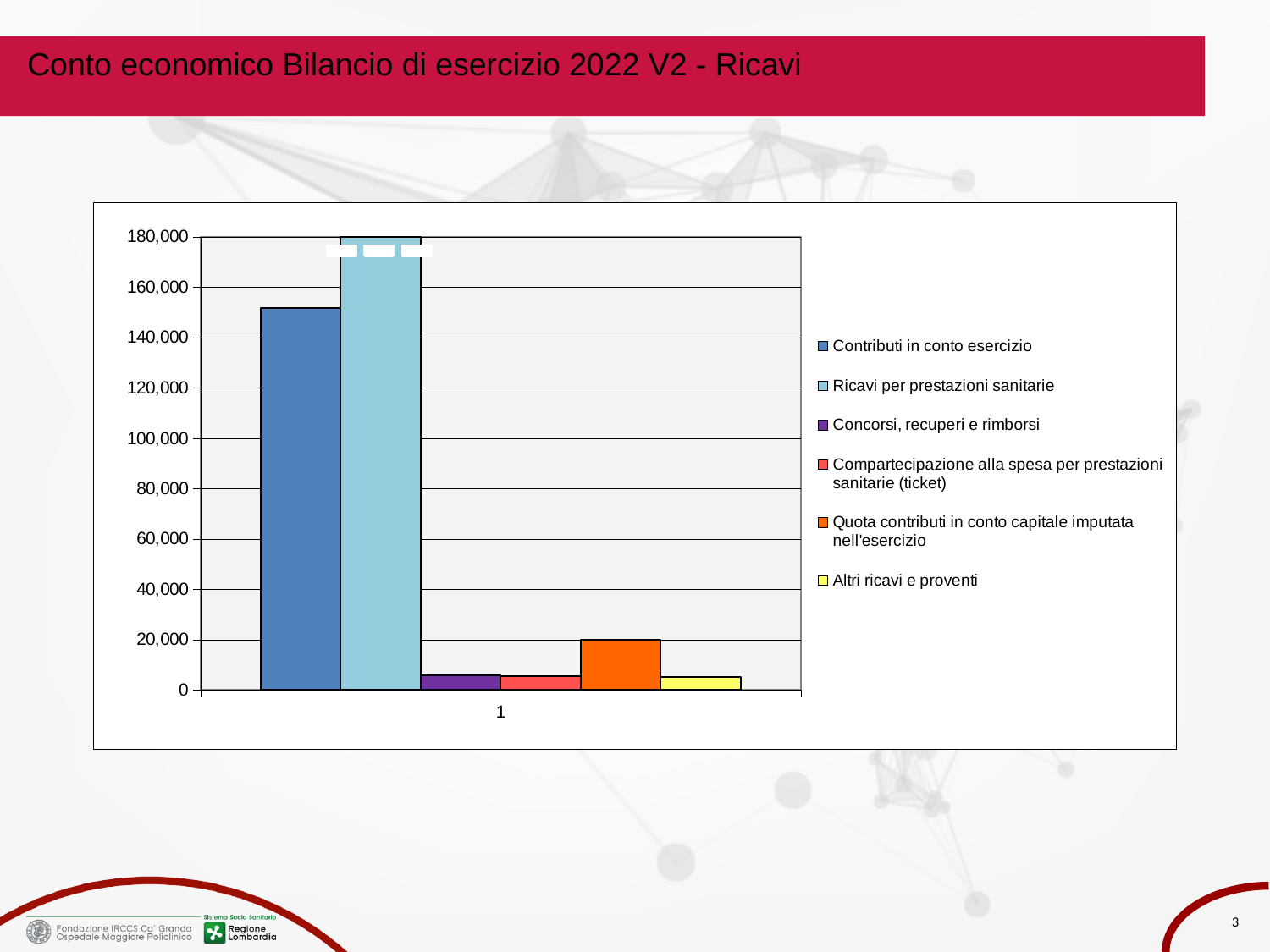
Which is larger, Quota contributi in conto capitale imputata nell'esercizio or Concorsi, recuperi e rimborsi? Quota contributi in conto capitale imputata nell'esercizio Which is larger, Contributi in conto esercizio or Ricavi per prestazioni sanitarie? Ricavi per prestazioni sanitarie What kind of chart is shown on the slide? bar chart Is the value for Quota contributi in conto capitale imputata nell'esercizio greater or less than 40,000? less Is the value for Contributi in conto esercizio greater or less than 160,000? less What colour is the bar for Altri ricavi e proventi? yellow Is the value for Contributi in conto esercizio greater or less than 140,000? greater How many series does the legend list? 6 How many categories are shown on the x axis? 1 Which series has the highest value? Ricavi per prestazioni sanitarie What is the title of the slide containing the chart? Conto economico Bilancio di esercizio 2022 V2 - Ricavi